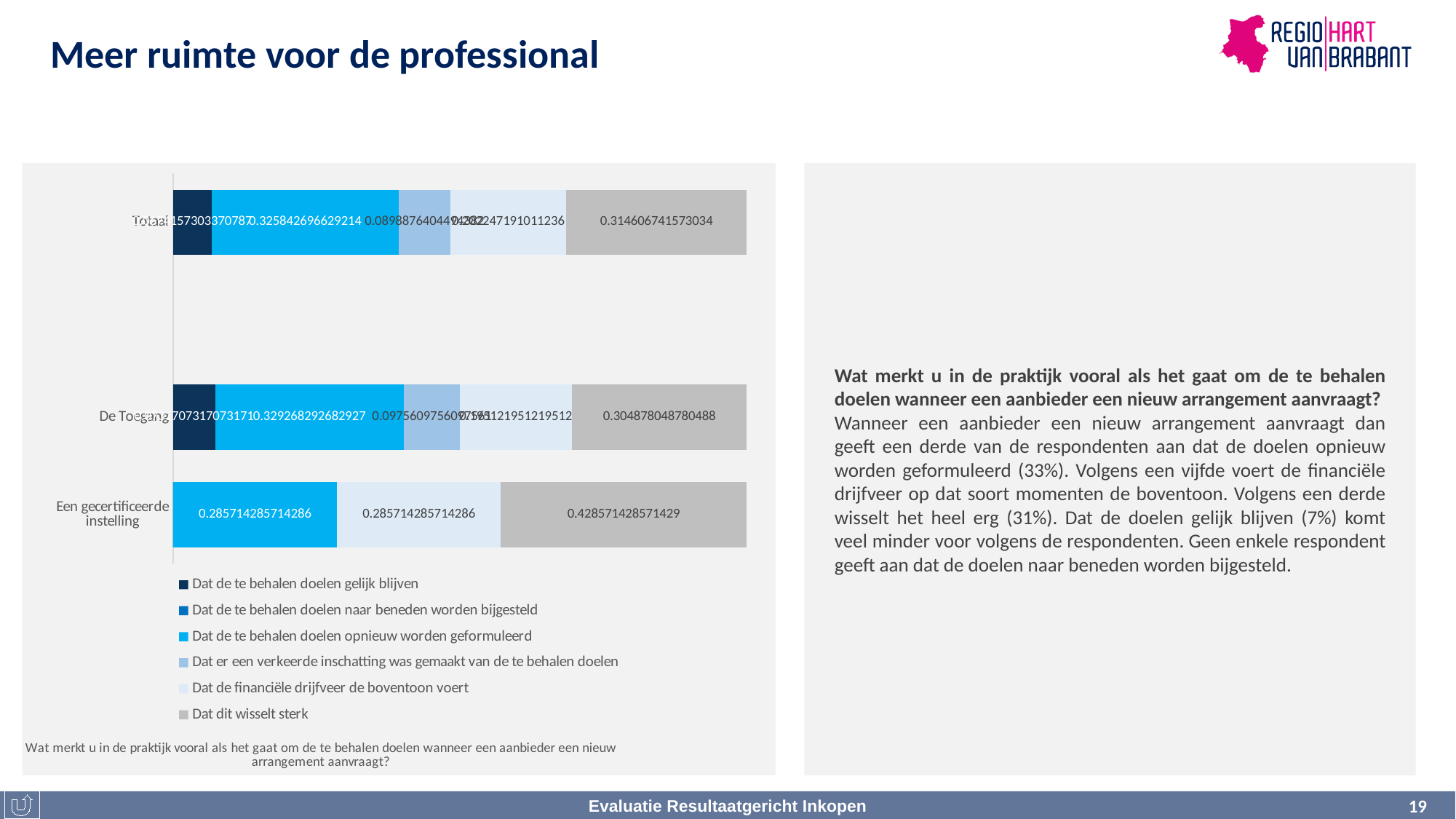
What kind of chart is shown on the slide? Stacked bar chart What is the value for 'Dat dit wisselt sterk' in the 'Totaal' bar? 0.314606741573034 Which series has the largest segment in the 'Een gecertificeerde instelling' bar? Dat dit wisselt sterk How many categories (bars) are plotted in the chart? 3 What is the value for 'Dat dit wisselt sterk' in the 'De Toegang' bar? 0.304878048780488 What is the value for 'Dat de te behalen doelen opnieuw worden geformuleerd' in the 'Een gecertificeerde instelling' bar? 0.285714285714286 What is the value for 'Dat de te behalen doelen opnieuw worden geformuleerd' in the 'Totaal' bar? 0.325842696629214 How many series does the chart legend list? 6 What is the value for 'Dat de te behalen doelen opnieuw worden geformuleerd' in the 'De Toegang' bar? 0.329268292682927 What is the value for 'Dat dit wisselt sterk' in the 'Een gecertificeerde instelling' bar? 0.428571428571429 What is the difference between the 'Dat dit wisselt sterk' value and the 'Dat de te behalen doelen opnieuw worden geformuleerd' value in the 'Een gecertificeerde instelling' bar? 0.142857142857143 Which is larger: the 'Dat dit wisselt sterk' value for 'Totaal' or for 'De Toegang'? Totaal